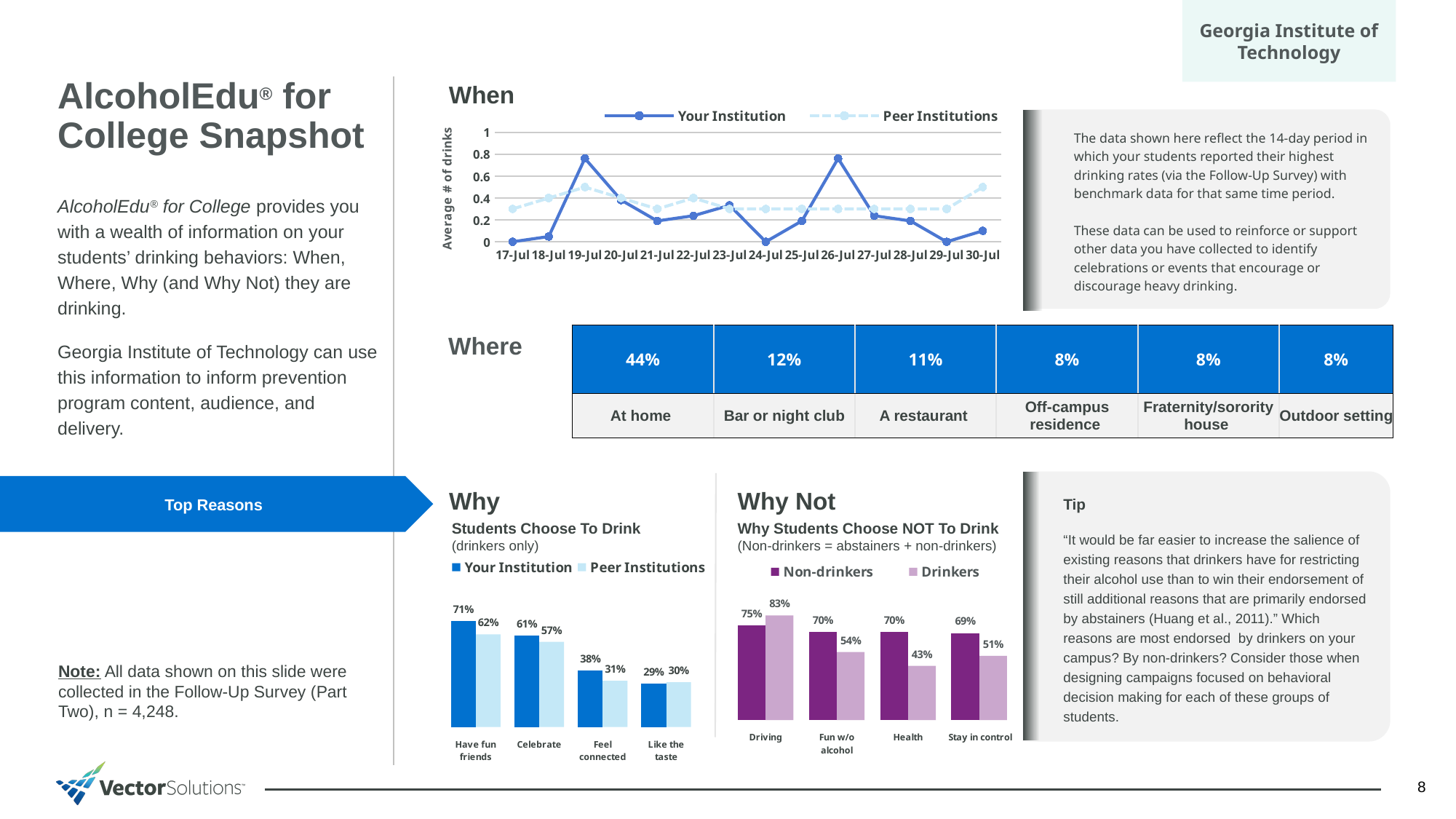
In the 'Why Not' chart, which reason has the lowest Drinkers value? Health In the 'Why' chart, what is the difference between the Your Institution and Peer Institutions values for 'Have fun friends'? 9% In the 'Why Not' chart (Why Students Choose NOT To Drink), what is the Drinkers value for 'Driving'? 83% In the 'Why' chart, which is larger for 'Like the taste': Your Institution or Peer Institutions? Peer Institutions How many reasons are shown on the x axis of the 'Why Not' chart? 4 In the 'Why' chart, which reason has the lowest Your Institution value? Like the taste In the 'Why Not' chart, what is the difference between the Non-drinkers and Drinkers values for 'Health'? 27% In the 'Why Not' chart, what is the Non-drinkers value for 'Stay in control'? 69% In the 'Why' chart (Students Choose To Drink), what is the Your Institution value for 'Have fun friends'? 71% In the 'When' chart, is the Your Institution value on 19-Jul greater or less than 0.6? greater In the 'Why' chart, what is the Peer Institutions value for 'Feel connected'? 31% What kind of chart is the 'When' chart? Line chart